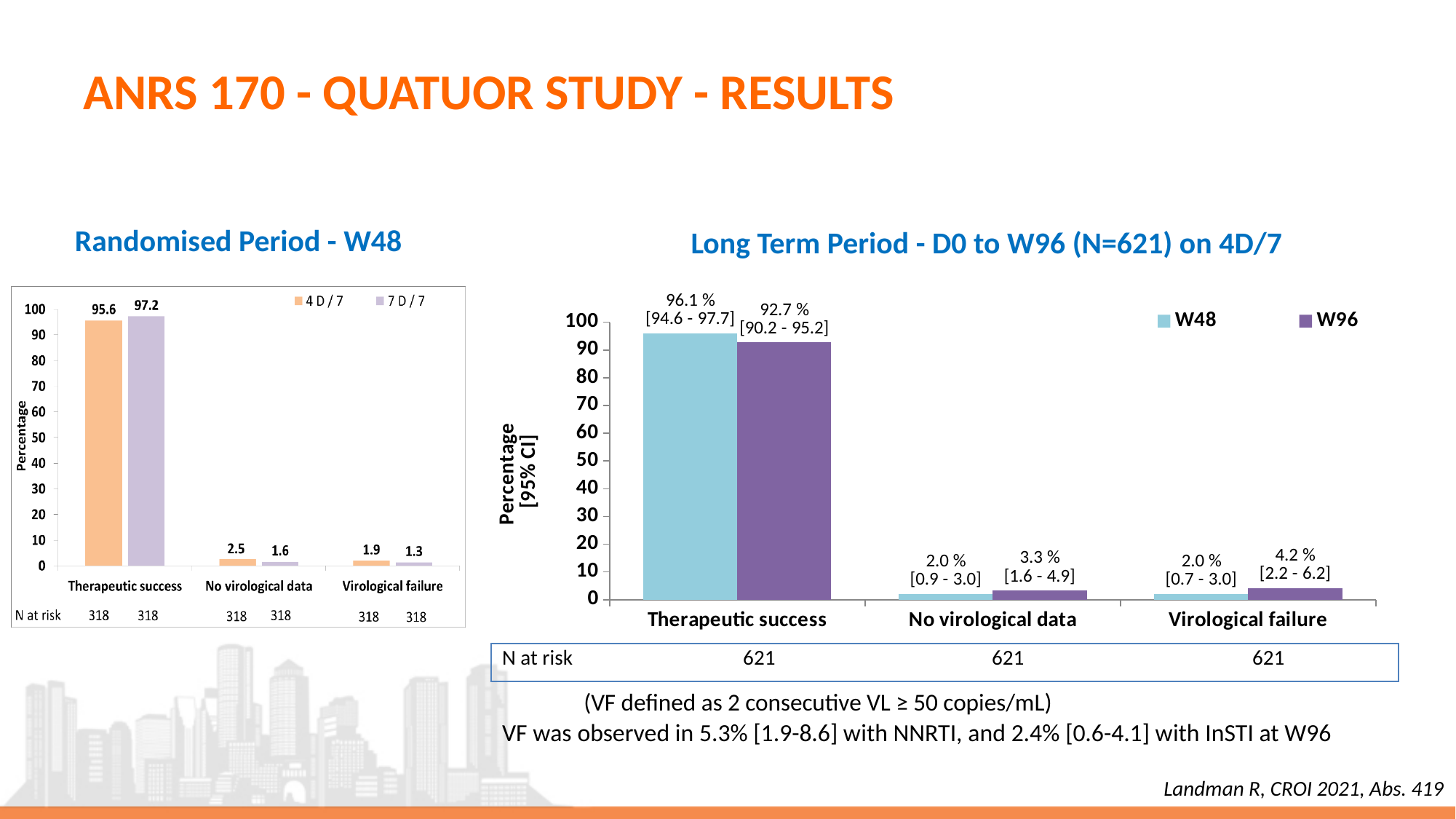
In the Long Term Period chart, what is the difference between the W48 and W96 values for Therapeutic success? 3.4 % In the Randomised Period - W48 chart, what is the value for Therapeutic success in the 4 D / 7 series? 95.6 What type of chart is the Randomised Period - W48 chart? Bar chart How many series does the legend of the Long Term Period chart list? 2 In the Long Term Period chart, what is the W48 value for Therapeutic success? 96.1 % In the Long Term Period chart, which category has the lowest W48 value? No virological data and Virological failure (both 2.0 %) In the Randomised Period - W48 chart, what is the difference between the 7 D / 7 and 4 D / 7 values for Therapeutic success? 1.6 In the Long Term Period chart, is the W96 value for Therapeutic success greater or less than 90? greater In the Randomised Period - W48 chart, what is the value for Virological failure in the 7 D / 7 series? 1.3 How many categories are shown on the x axis of the Long Term Period chart? 3 In the Long Term Period chart, what is the W96 value for Virological failure? 4.2 % In the Randomised Period - W48 chart, which series has the larger value for No virological data, 4 D / 7 or 7 D / 7? 4 D / 7